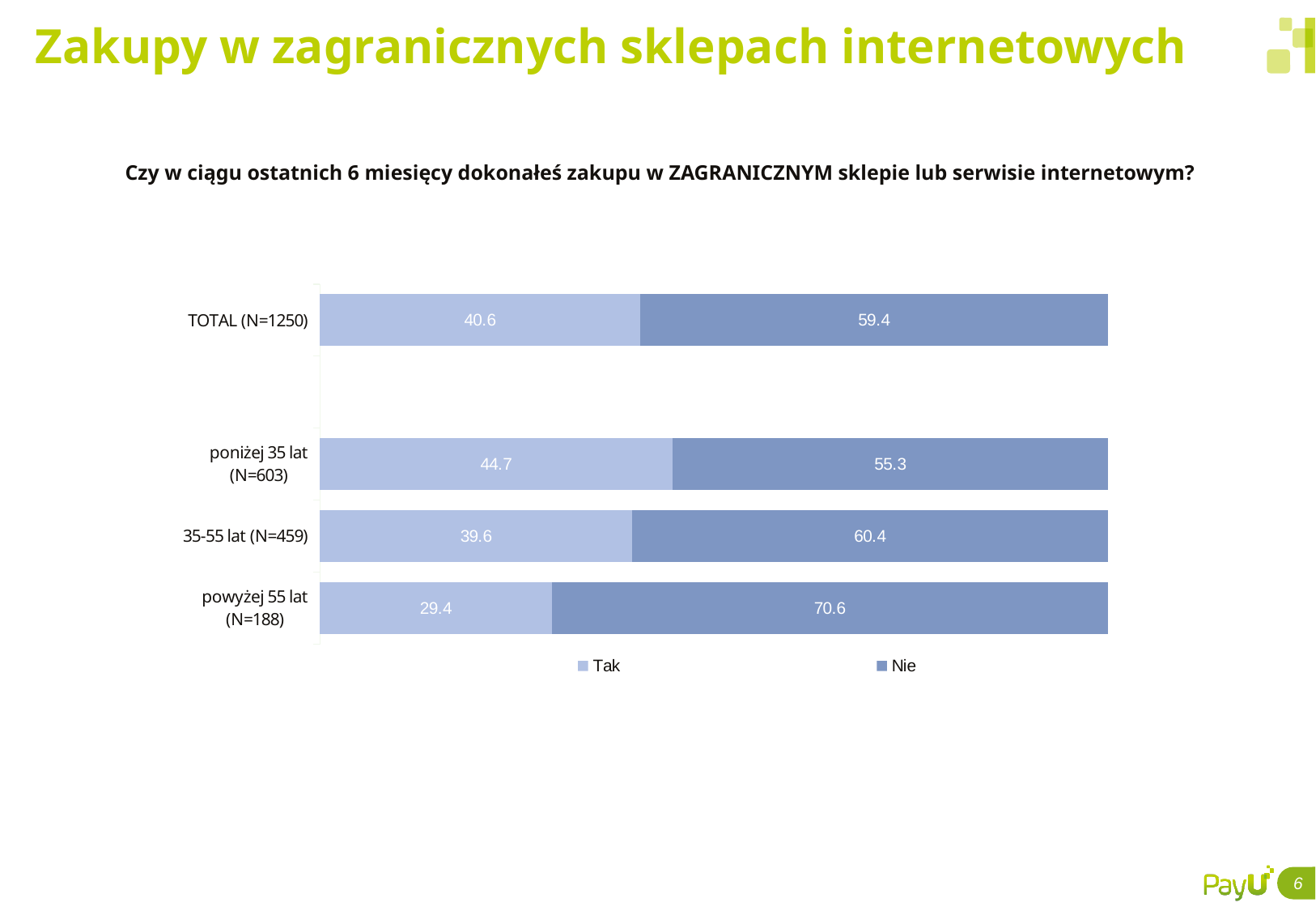
How many categories are shown on the chart? 4 What is the "Tak" value for poniżej 35 lat (N=603)? 44.7 Which category has the highest "Tak" value? poniżej 35 lat (N=603) What is the total of the stacked bar for 35-55 lat (N=459)? 100 Which is larger: the "Tak" value for 35-55 lat (N=459) or the "Tak" value for TOTAL (N=1250)? TOTAL (N=1250) What is the "Nie" value for powyżej 55 lat (N=188)? 70.6 What is the "Nie" value for 35-55 lat (N=459)? 60.4 Which category has the lowest "Tak" value? powyżej 55 lat (N=188) What is the difference between the "Nie" value for powyżej 55 lat (N=188) and the "Nie" value for poniżej 35 lat (N=603)? 15.3 What is the "Tak" value for TOTAL (N=1250)? 40.6 What kind of chart is shown on the slide? Stacked bar chart How many series does the legend list? 2